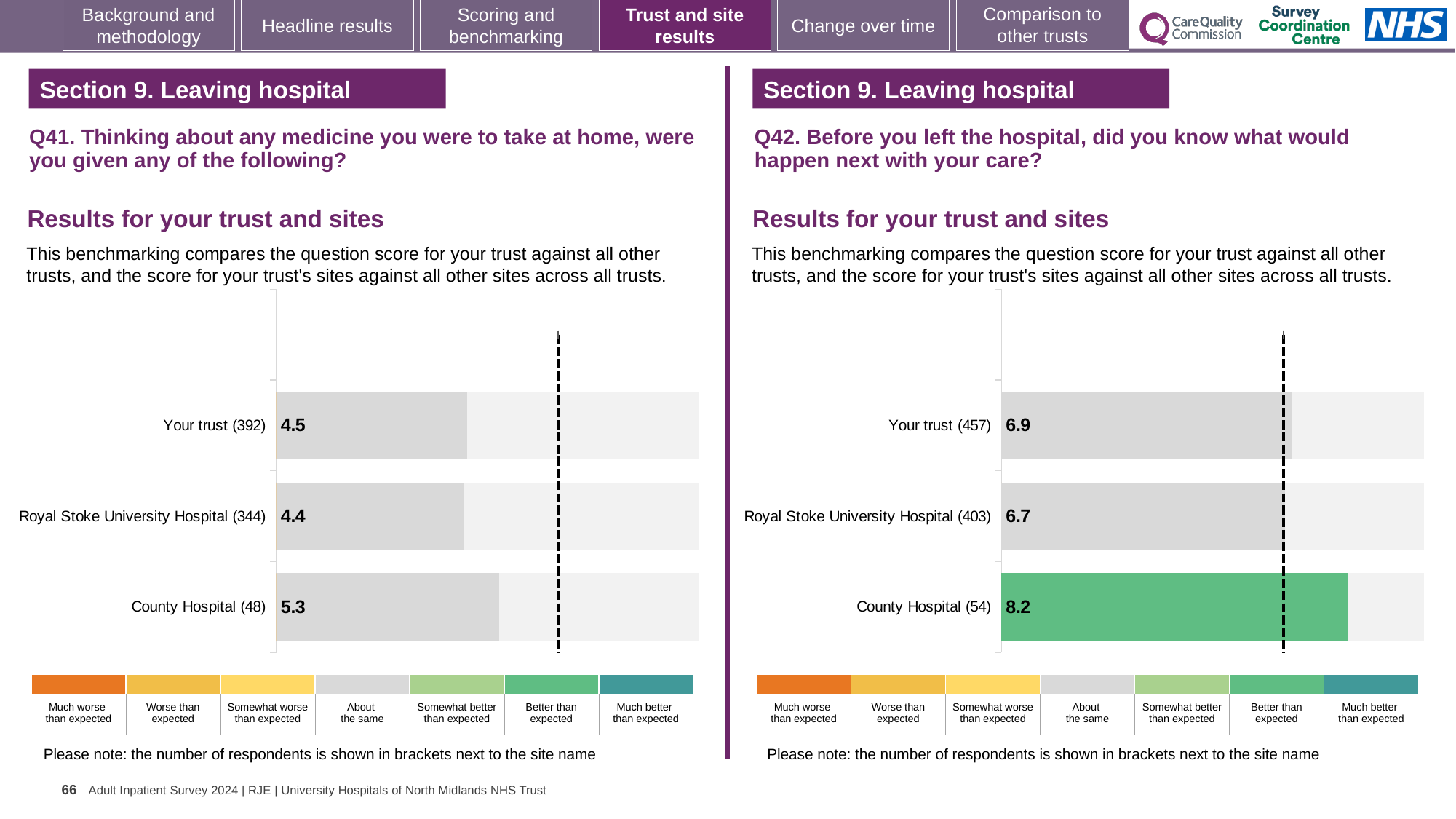
How many bars are plotted on the Q41 chart (left)? 3 On the Q42 chart (right), what is the score for Royal Stoke University Hospital? 6.7 On the Q41 chart (left), what is the difference between the County Hospital score and the Royal Stoke University Hospital score? 0.9 On the Q42 chart (right), which site or trust has the lowest score? Royal Stoke University Hospital On the Q41 chart (left), which site or trust has the highest score? County Hospital On the Q41 chart (left), what is the score for County Hospital? 5.3 On the Q42 chart (right), what is the difference between the County Hospital score and the Your trust score? 1.3 On the Q42 chart (right), what is the score for County Hospital? 8.2 What kind of chart is used on the Q42 chart (right)? Bar chart On the Q42 chart (right), which has the larger score, Your trust or Royal Stoke University Hospital? Your trust On the Q41 chart (left), what is the score for Your trust? 4.5 On the Q42 chart (right), how many respondents are shown in brackets for County Hospital? 54